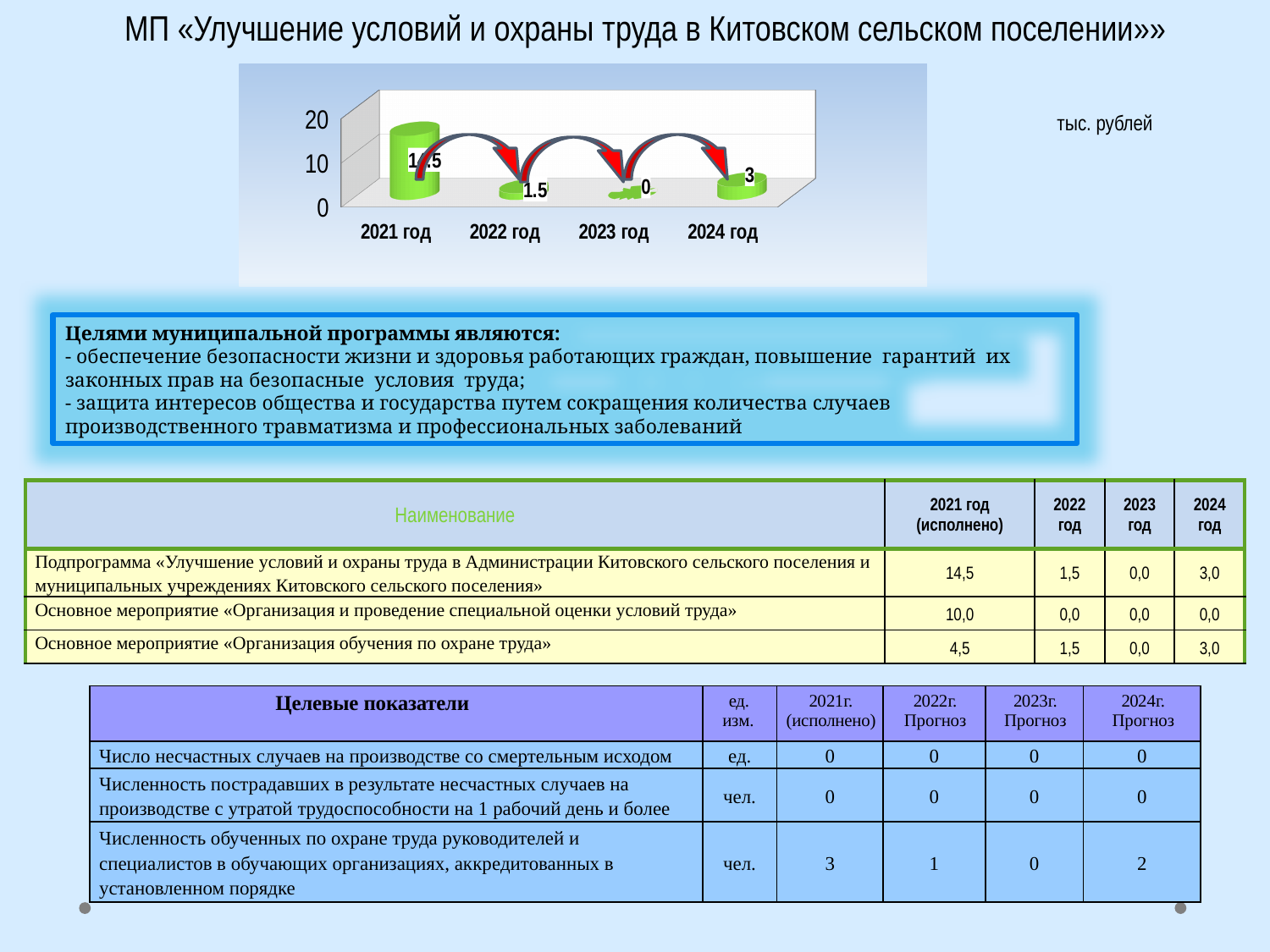
Which year has the lowest value in the chart? 2023 год What kind of chart is shown on the slide? bar chart How many years are shown on the x axis of the chart? 4 Is the value for 2021 год greater or less than 10? greater Which is larger, the value for 2022 год or the value for 2024 год? 2024 год Which year has the highest value in the chart? 2021 год Do the values fall or rise from 2021 год to 2023 год? fall What is the value for 2022 год in the chart? 1,5 What is the difference between the values for 2024 год and 2022 год? 1,5 What is the value for 2023 год in the chart? 0 What unit is indicated next to the chart? тыс. рублей What is the value for 2024 год in the chart? 3